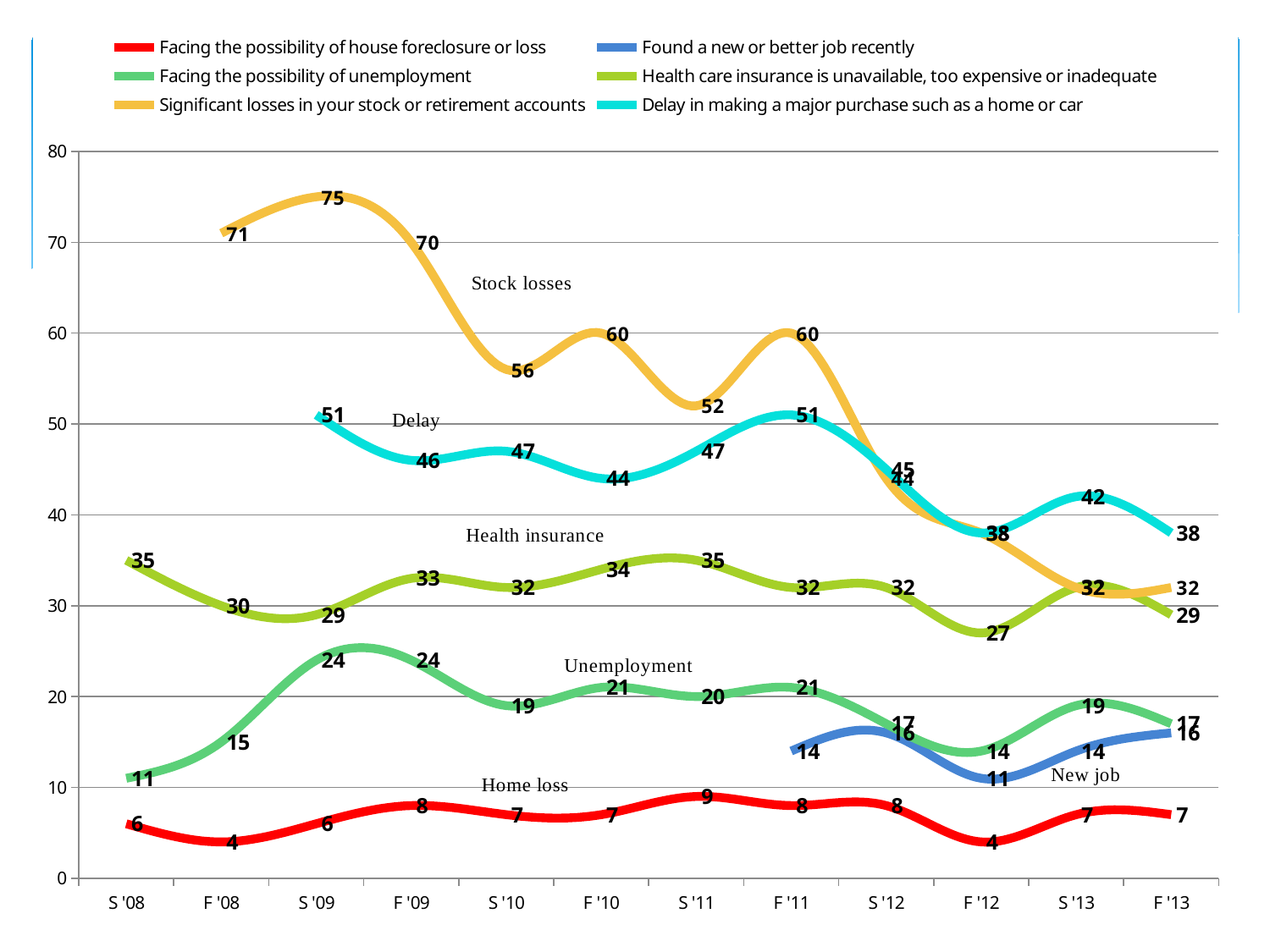
What kind of chart is shown on the slide? line chart Does the 'Stock losses' line generally rise or fall from S '09 to F '13? fall At F '11, which is larger: the 'Delay' value or the 'Health insurance' value? Delay What is the value for 'Facing the possibility of house foreclosure or loss' at S '11? 9 At which period does the 'Stock losses' line reach its highest value? S '09 What is the difference between the 'Stock losses' values at S '09 and F '09? 5 What is the value for 'Found a new or better job recently' at F '12? 11 How many time periods are shown along the x axis? 12 What is the value for 'Significant losses in your stock or retirement accounts' at S '09? 75 At which period is the 'Health insurance' line at its lowest value? F '12 What is the value for 'Health care insurance is unavailable, too expensive or inadequate' at F '12? 27 How many series does the legend list? 6